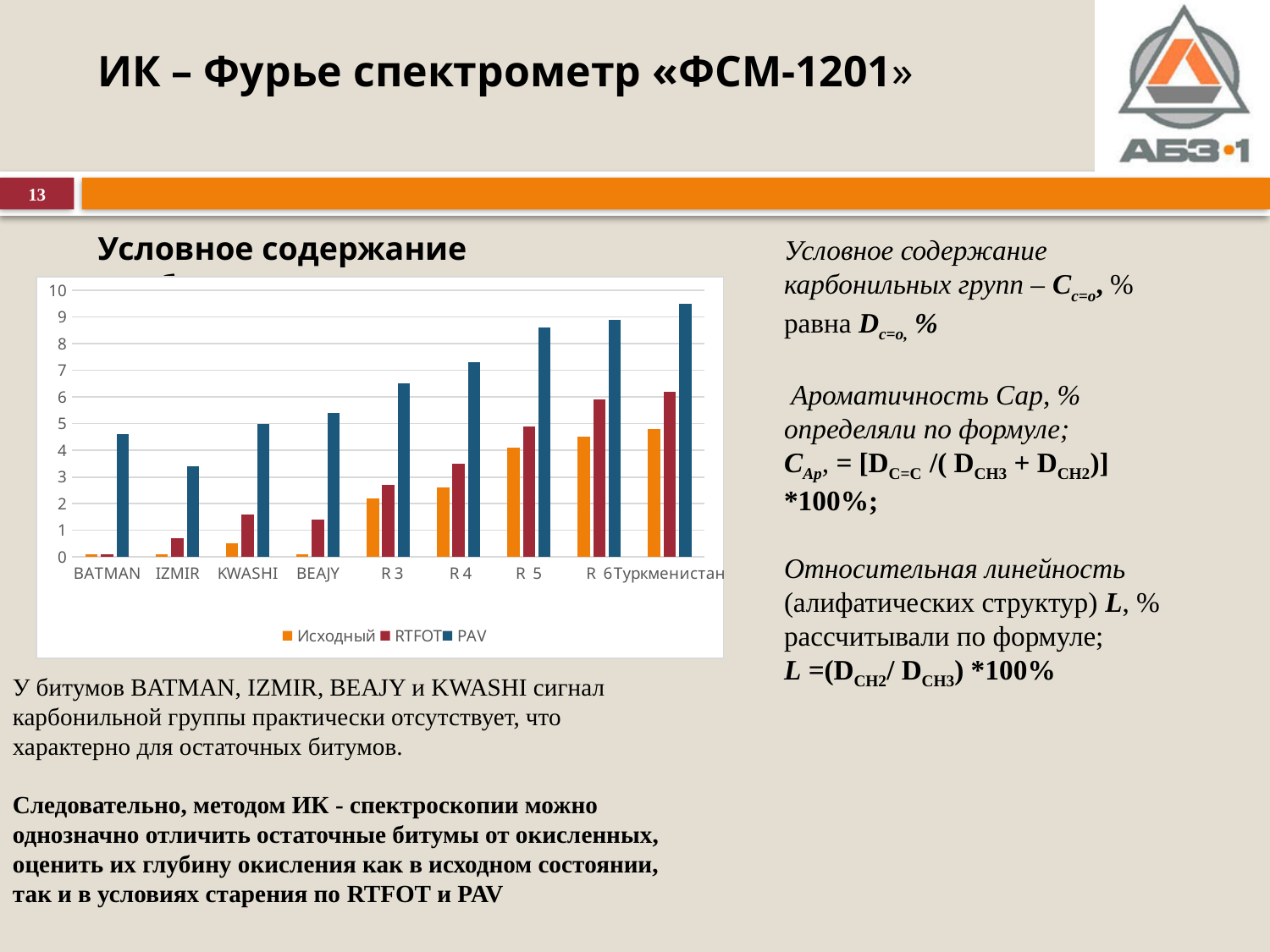
How many categories are shown on the x axis of the chart? 9 Is the PAV value for IZMIR greater or less than 4? less What kind of chart is shown on the slide? bar chart Do the PAV values rise or fall from R 3 to Туркменистан along the x axis? rise Which series are listed in the chart legend? Исходный, RTFOT, PAV Which category has the highest PAV value? Туркменистан How many series does the chart legend list? 3 Is the RTFOT value for R 6 greater or less than 5? greater Which category has the lowest PAV value? IZMIR Is the RTFOT value for KWASHI greater or less than 2? less For R 3, which is larger: the PAV value or the RTFOT value? PAV